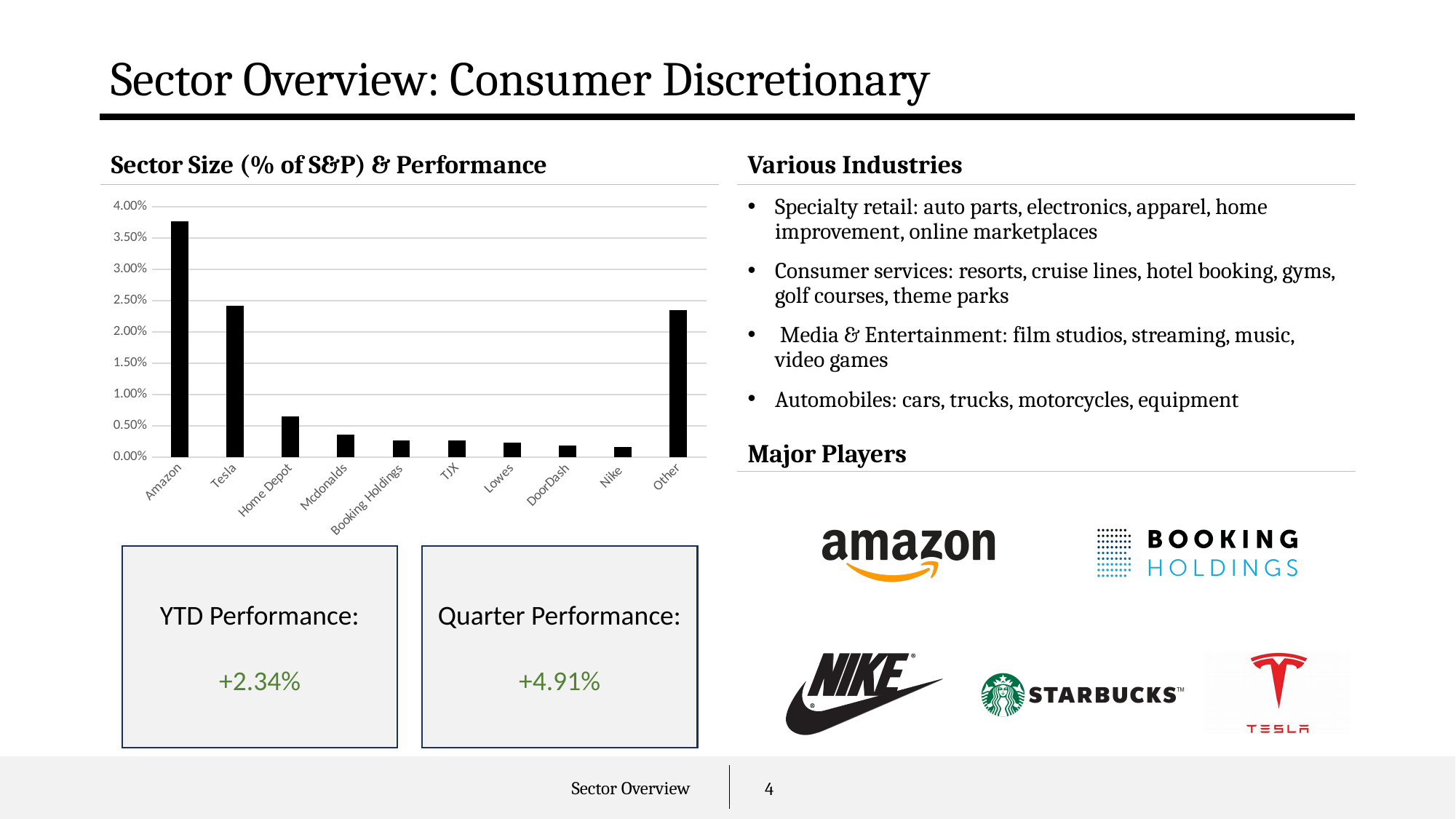
In the Sector Size bar chart, is the value for Mcdonalds greater or less than 0.50%? less In the Sector Size bar chart, is the value for Other greater or less than 2.00%? greater What is the highest value shown on the y-axis of the Sector Size bar chart? 4.00% In the Sector Size bar chart, which is larger, the value for Home Depot or the value for Mcdonalds? Home Depot Which category has the highest value in the Sector Size bar chart? Amazon What is the title of the bar chart on the slide? Sector Size (% of S&P) & Performance What kind of chart is shown under "Sector Size (% of S&P) & Performance"? bar chart In the Sector Size bar chart, which is larger, the value for Amazon or the value for Tesla? Amazon In the Sector Size bar chart, is the value for Amazon greater or less than 3.50%? greater How many companies/categories are plotted in the Sector Size bar chart? 10